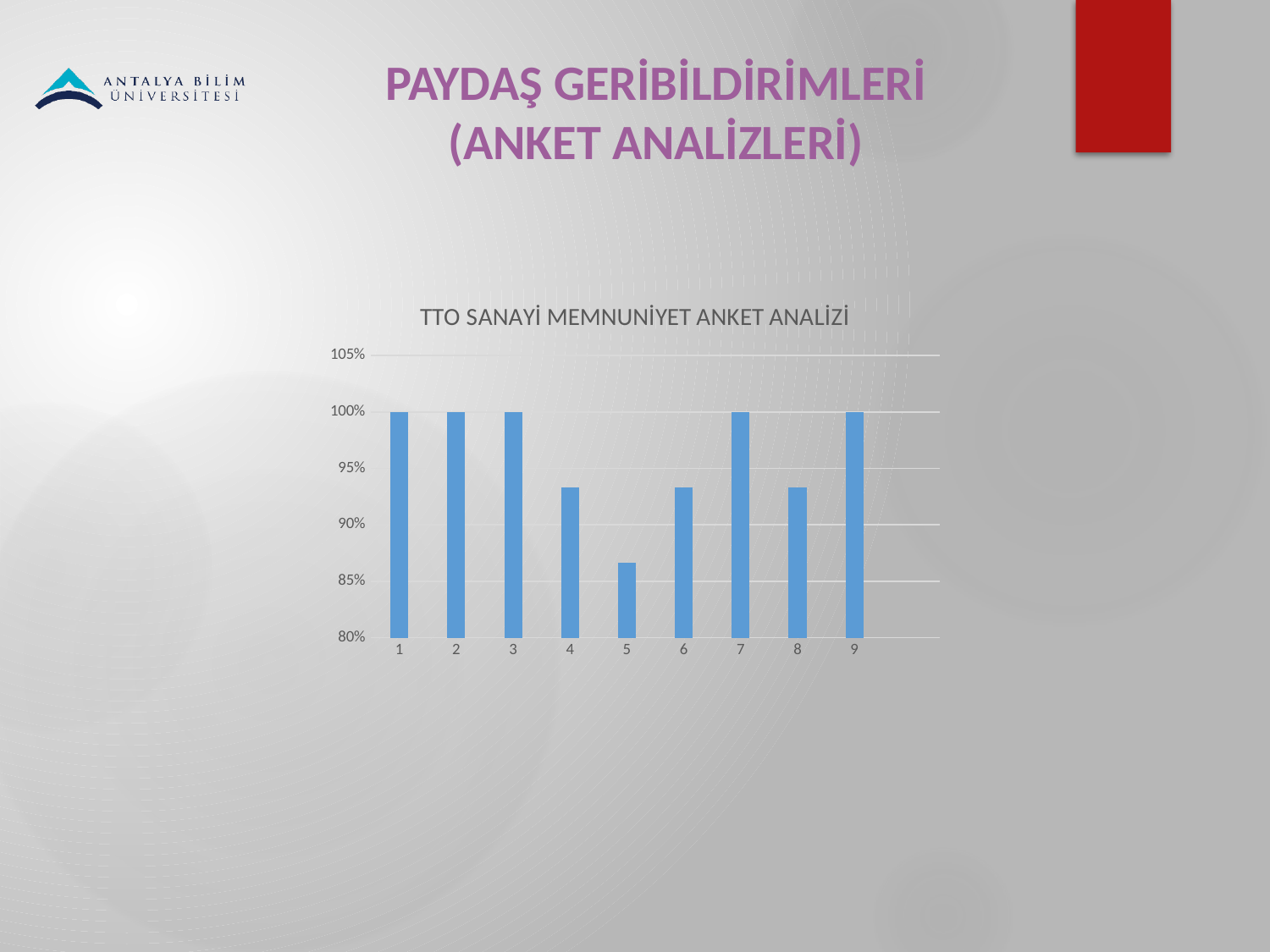
How many categories are shown on the x axis of the chart? 9 Is the value for category 8 greater or less than 95%? less What type of chart is shown on the slide? bar chart Which is larger, the value for category 4 or the value for category 5? category 4 Is the value for category 4 greater or less than 90%? greater Is the value for category 5 greater or less than 90%? less Which category has the lowest value? 5 What is the value for category 1? 100% Which is larger, the value for category 2 or the value for category 6? category 2 What is the value for category 7? 100% What is the title of the chart? TTO SANAYİ MEMNUNİYET ANKET ANALİZİ What is the value for category 9? 100%